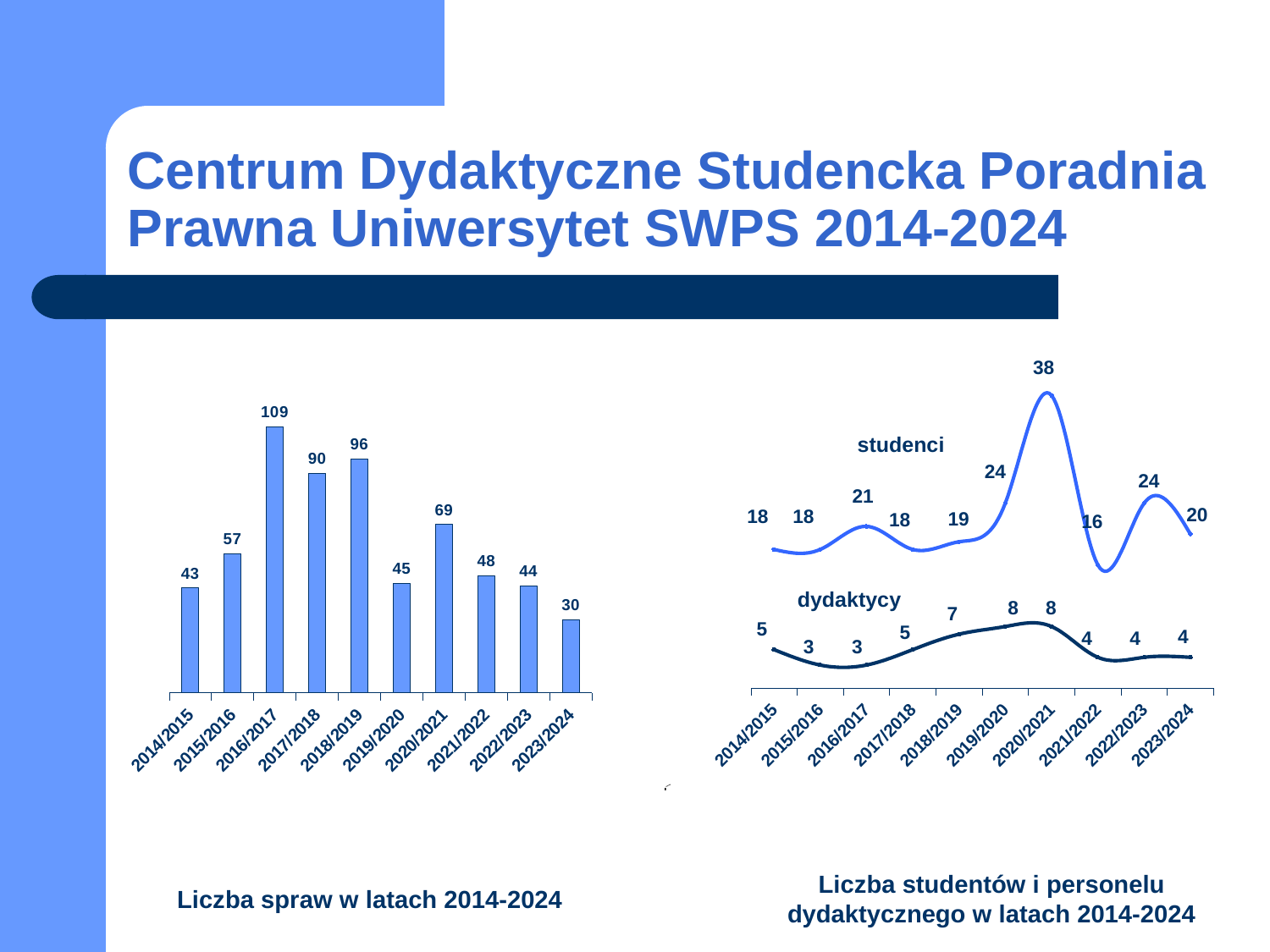
What kind of chart is the right chart (Liczba studentów i personelu dydaktycznego w latach 2014-2024)? line chart In the left chart (Liczba spraw w latach 2014-2024), what is the difference between the values for 2018/2019 and 2019/2020? 51 What kind of chart is the left chart (Liczba spraw w latach 2014-2024)? bar chart In the right chart (Liczba studentów i personelu dydaktycznego w latach 2014-2024), which is larger in 2021/2022: studenci or dydaktycy? studenci How many series are plotted in the right chart (Liczba studentów i personelu dydaktycznego w latach 2014-2024)? 2 In the right chart (Liczba studentów i personelu dydaktycznego w latach 2014-2024), what is the value for studenci in 2020/2021? 38 In the left chart (Liczba spraw w latach 2014-2024), how many years are shown on the x axis? 10 In the right chart (Liczba studentów i personelu dydaktycznego w latach 2014-2024), what is the difference between studenci and dydaktycy in 2020/2021? 30 In the left chart (Liczba spraw w latach 2014-2024), which year has the highest value? 2016/2017 In the left chart (Liczba spraw w latach 2014-2024), what is the value for 2016/2017? 109 In the left chart (Liczba spraw w latach 2014-2024), which year has the lowest value? 2023/2024 In the right chart (Liczba studentów i personelu dydaktycznego w latach 2014-2024), what is the value for dydaktycy in 2018/2019? 7